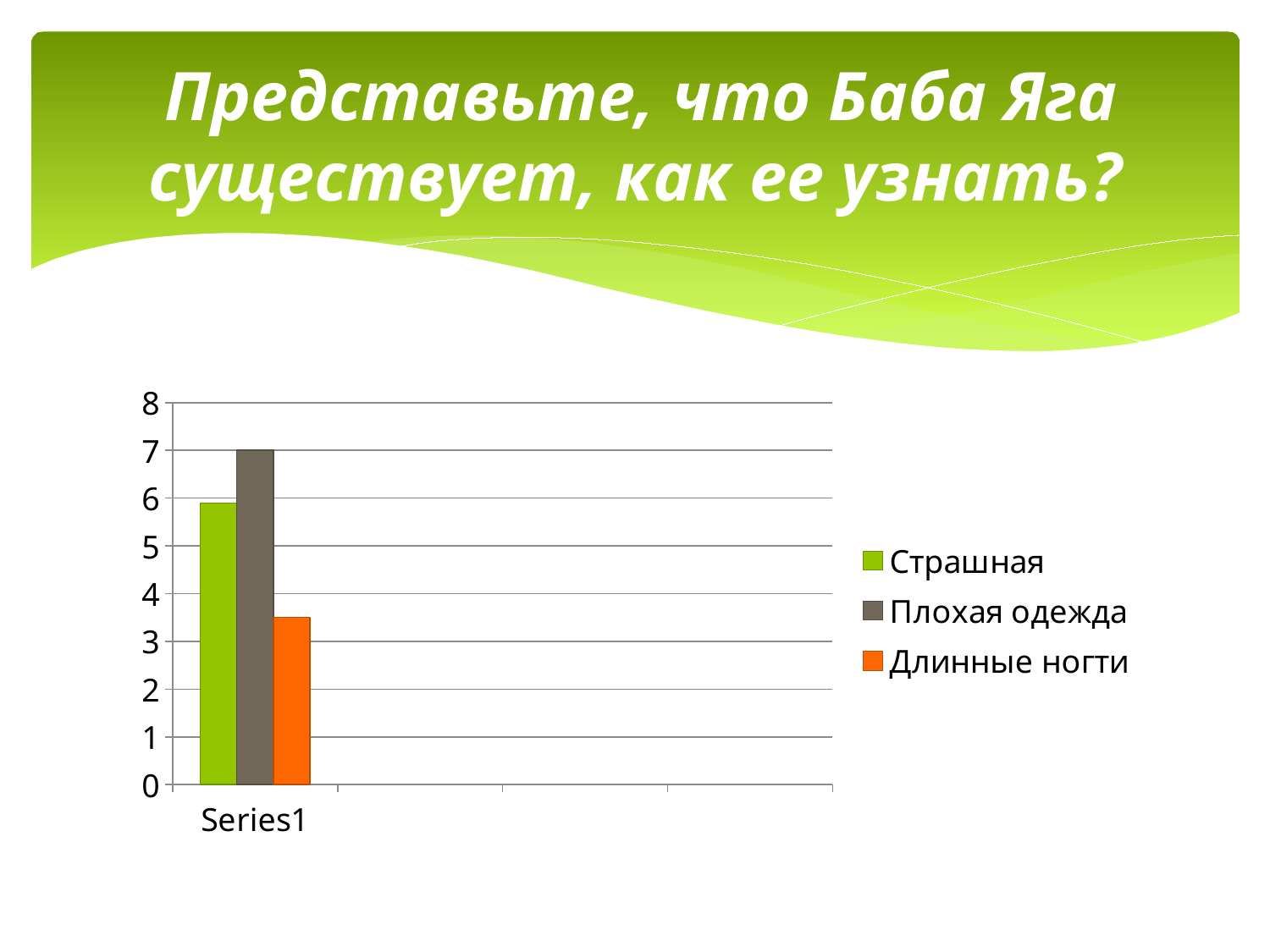
How many series does the legend list? 3 How many categories are shown on the x axis? 1 What is the label of the category on the x axis? Series1 What colour is the bar for Длинные ногти? orange Is the value for Страшная greater or less than 5? greater What is the value of the Плохая одежда bar? 7 Which series has the highest bar? Плохая одежда Is the value for Длинные ногти greater or less than 4? less What kind of chart is shown on the slide? bar chart Which is larger, the value for Страшная or the value for Длинные ногти? Страшная Which series has the lowest bar? Длинные ногти